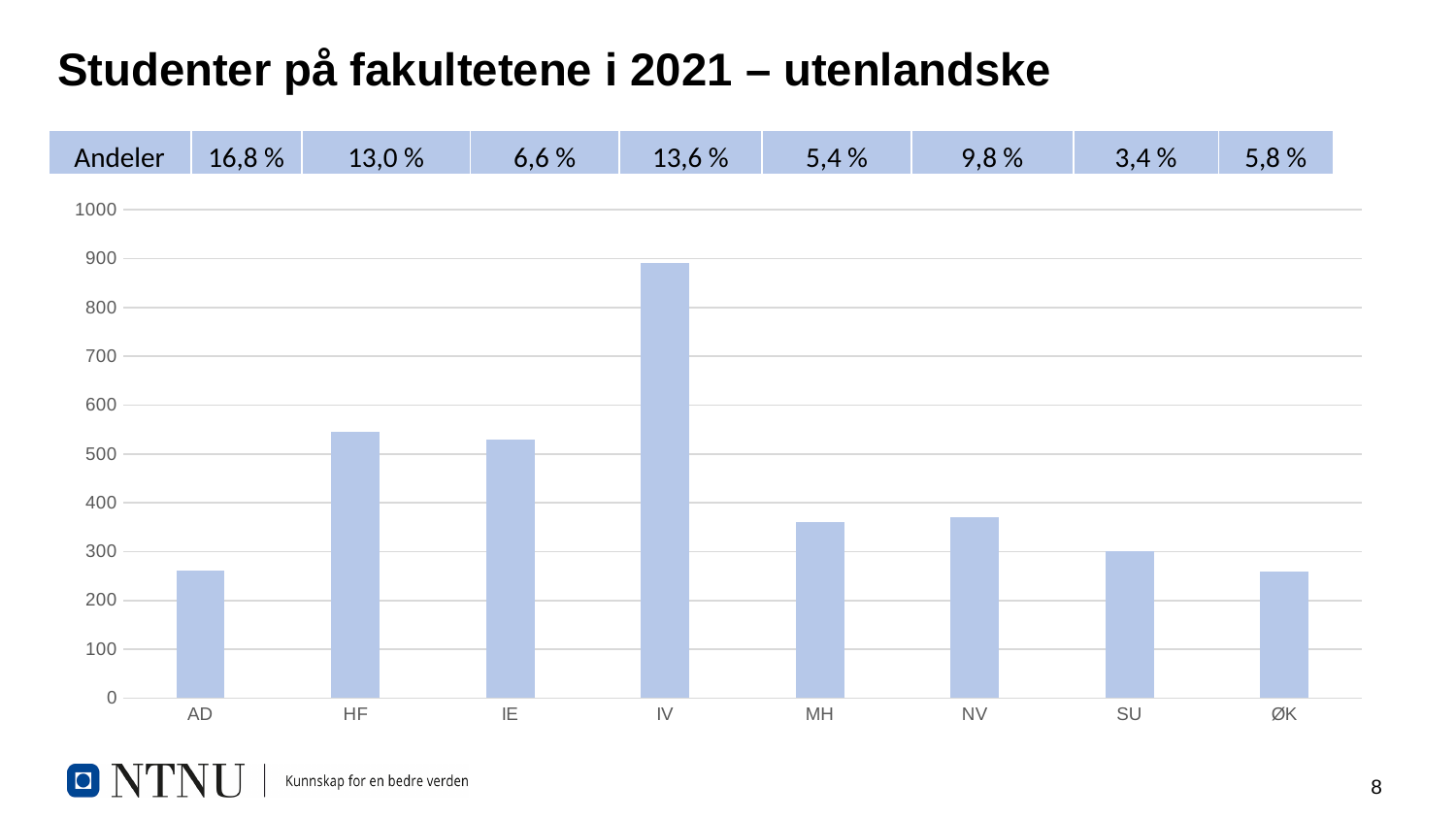
What is the 'Andeler' share shown for AD? 16,8 % Is the value for HF greater or less than 500? greater What is the title of the slide containing the chart? Studenter på fakultetene i 2021 – utenlandske What type of chart is shown on the slide? bar chart Which faculty has the highest bar in the chart? IV How many faculties (categories) are shown on the x axis of the chart? 8 Is the value for MH greater or less than 400? less What is the 'Andeler' share shown for NV? 9,8 % Which has a larger value, IV or HF? IV Is the value for AD greater or less than 300? less What is the 'Andeler' share shown for SU? 3,4 %